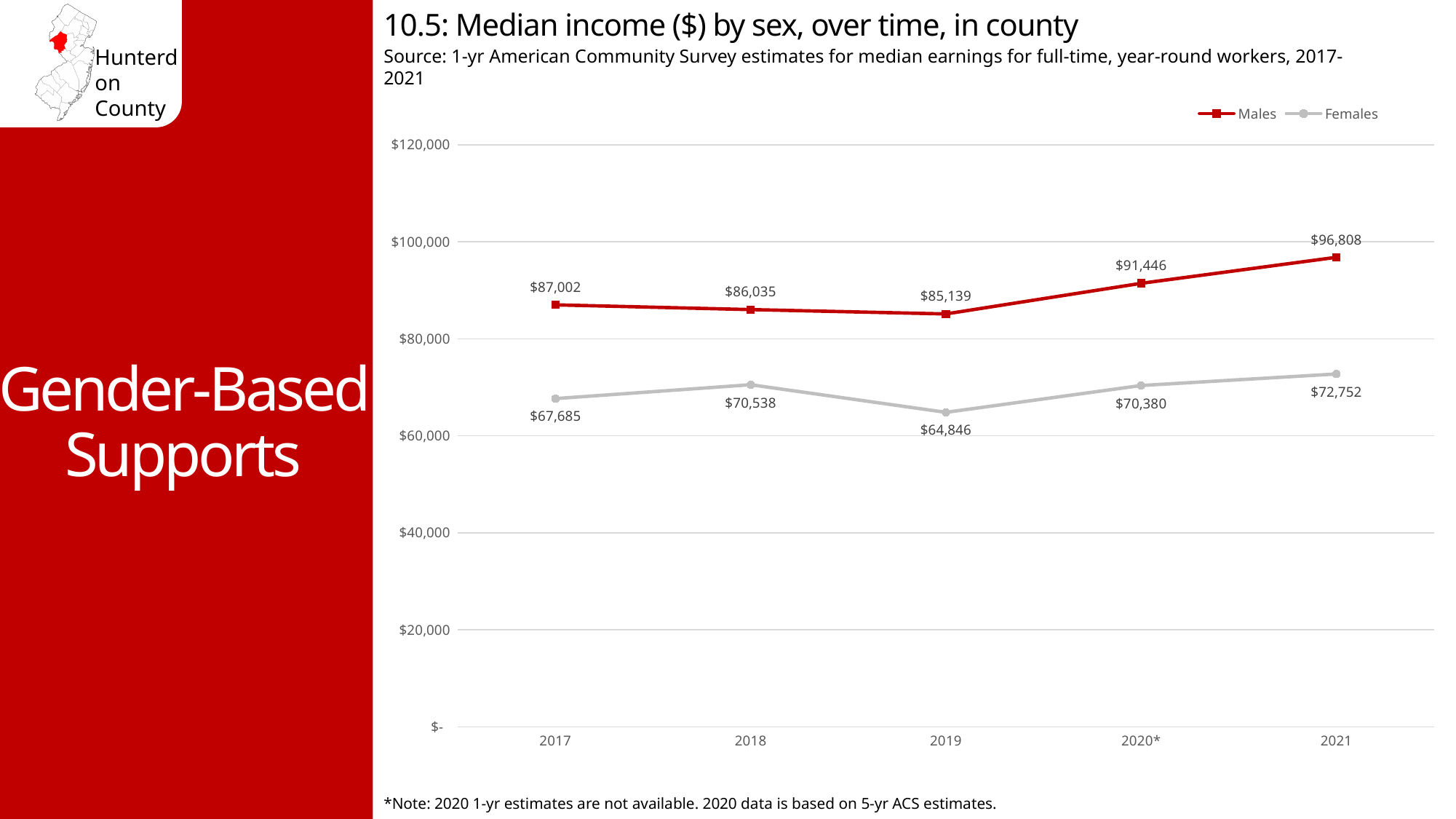
How many series does the legend list? 2 What is the median income for Males in 2021? $96,808 What is the median income for Females in 2017? $67,685 How many years are shown on the x axis? 5 What is the median income for Females in 2019? $64,846 What is the difference between the Males and Females median income in 2021? $24,056 Does the Males median income rise or fall from 2019 to 2021? Rise Which is larger, the Females median income in 2018 or in 2020*? 2018 What kind of chart is shown on the slide? Line chart In which year is the Females median income lowest? 2019 Is the Males median income in 2019 greater or less than $80,000? greater In which year is the Males median income highest? 2021